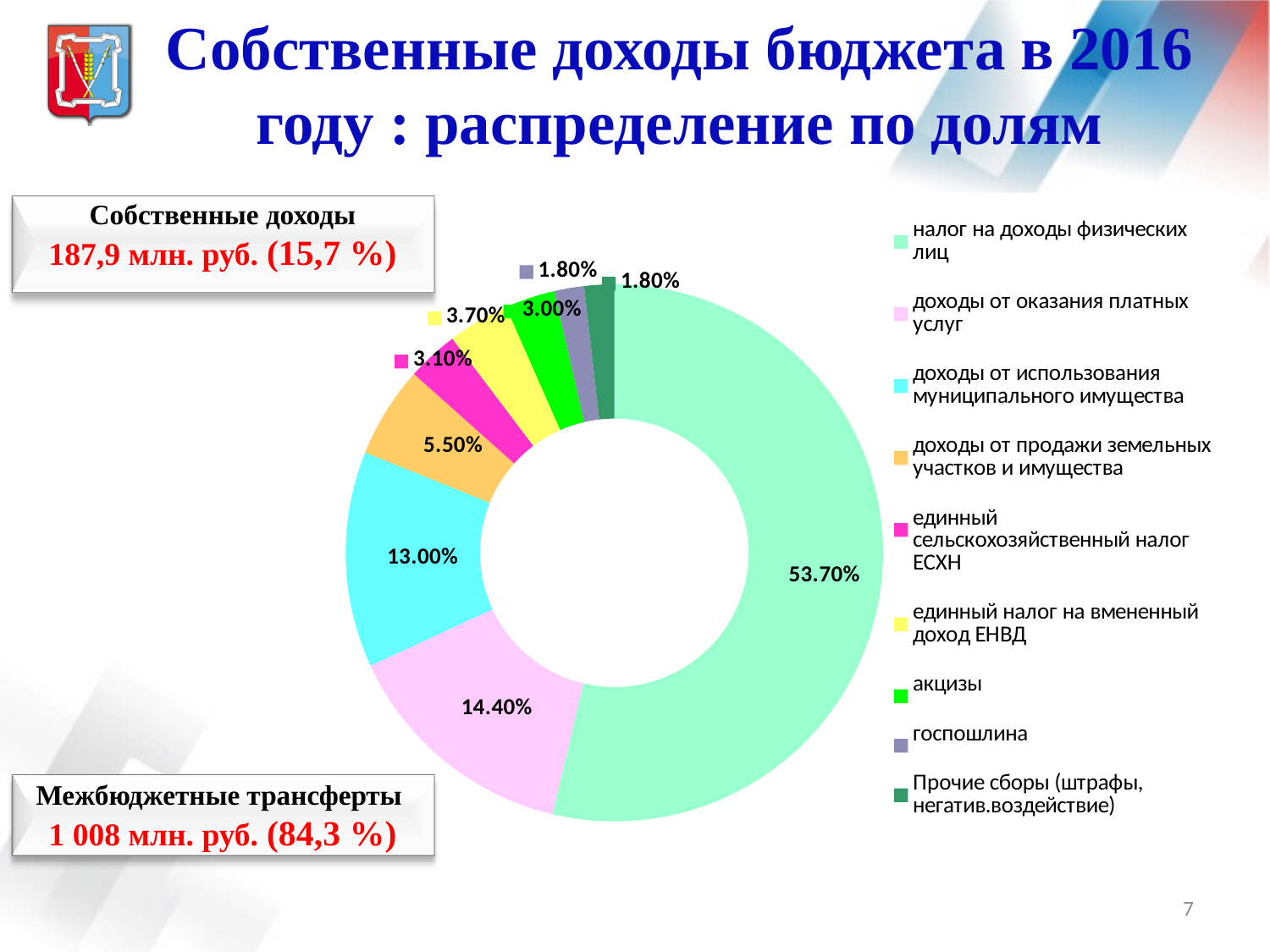
What is the difference between the share for доходы от продажи земельных участков и имущества and the share for госпошлина? 3.70% What colour is the slice for акцизы? green What kind of chart is shown on the slide? doughnut (pie) chart Which is larger: the share for единый сельскохозяйственный налог ЕСХН or the share for единый налог на вмененный доход ЕНВД? единый налог на вмененный доход ЕНВД What is the value shown for акцизы? 3.00% What is the value shown for доходы от использования муниципального имущества? 13.00% What is the difference between the shares of доходы от оказания платных услуг and доходы от использования муниципального имущества? 1.40% What is the value shown for доходы от оказания платных услуг? 14.40% Which category has the largest share of the chart? налог на доходы физических лиц What share of the chart does налог на доходы физических лиц account for? 53.70% How many categories does the chart show? 9 What is the value shown for единый налог на вмененный доход ЕНВД? 3.70%